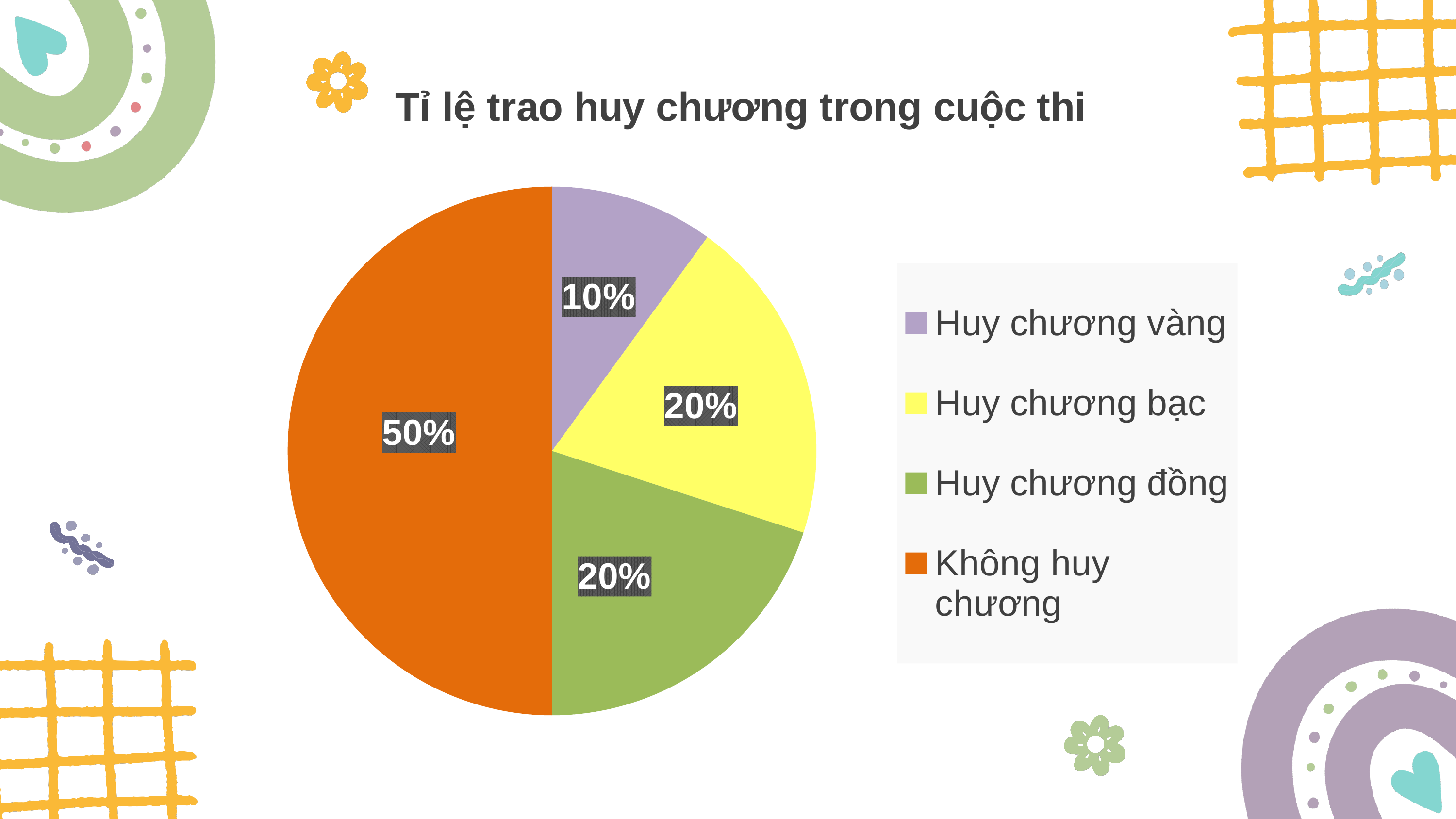
What kind of chart is shown on the slide? Pie chart What is the difference between the share for Không huy chương and the share for Huy chương đồng? 30% Which category has the smallest slice of the pie? Huy chương vàng Which is larger, the share for Huy chương bạc or the share for Huy chương vàng? Huy chương bạc How many categories does the pie chart have? 4 Which category has the largest slice of the pie? Không huy chương What is the combined share of Huy chương vàng, Huy chương bạc and Huy chương đồng? 50% What share of the pie is labelled for Huy chương vàng? 10% What share of the pie is labelled for Không huy chương? 50% What share of the pie is labelled for Huy chương bạc? 20% What colour is the slice for Huy chương đồng? Green What is the title of the chart? Tỉ lệ trao huy chương trong cuộc thi